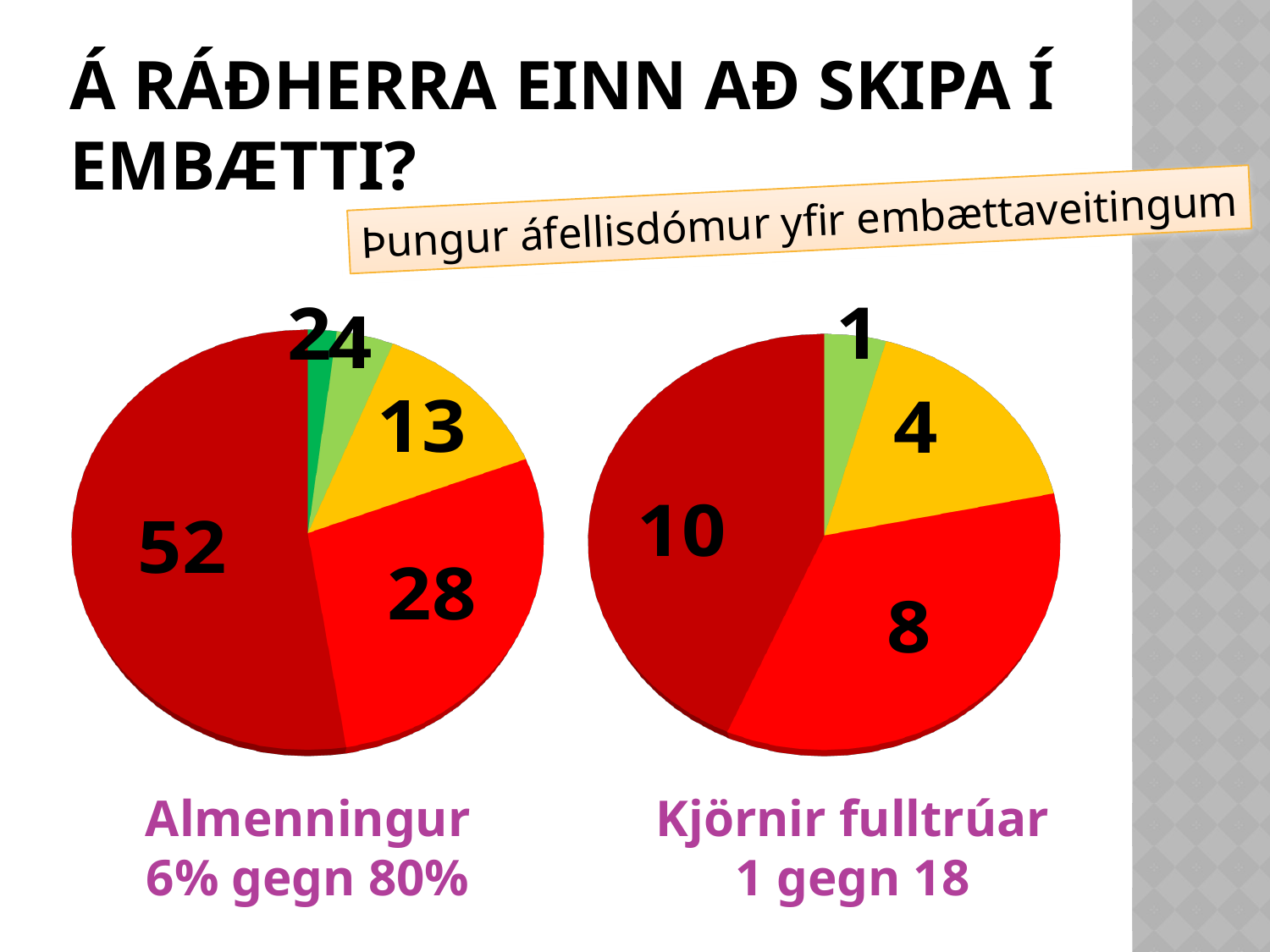
In the 'Almenningur' pie chart, what value is shown for the yellow slice? 13 How many slices does the 'Kjörnir fulltrúar' pie chart have? 4 In the 'Almenningur' pie chart, what is the difference between the dark red slice (52) and the bright red slice (28)? 24 In the 'Almenningur' pie chart, which value is the largest? 52 In the 'Kjörnir fulltrúar' pie chart, what value is shown for the bright red slice? 8 In the 'Kjörnir fulltrúar' pie chart, which value is the largest? 10 What type of charts are shown on the slide? Pie charts In the 'Kjörnir fulltrúar' pie chart, is the dark red slice (10) or the yellow slice (4) larger? The dark red slice (10) In the 'Kjörnir fulltrúar' pie chart, what value is shown for the green slice? 1 In the 'Almenningur' pie chart, which value is the smallest? 2 How many slices does the 'Almenningur' pie chart have? 5 In the 'Almenningur' pie chart, what value is shown for the largest (dark red) slice? 52